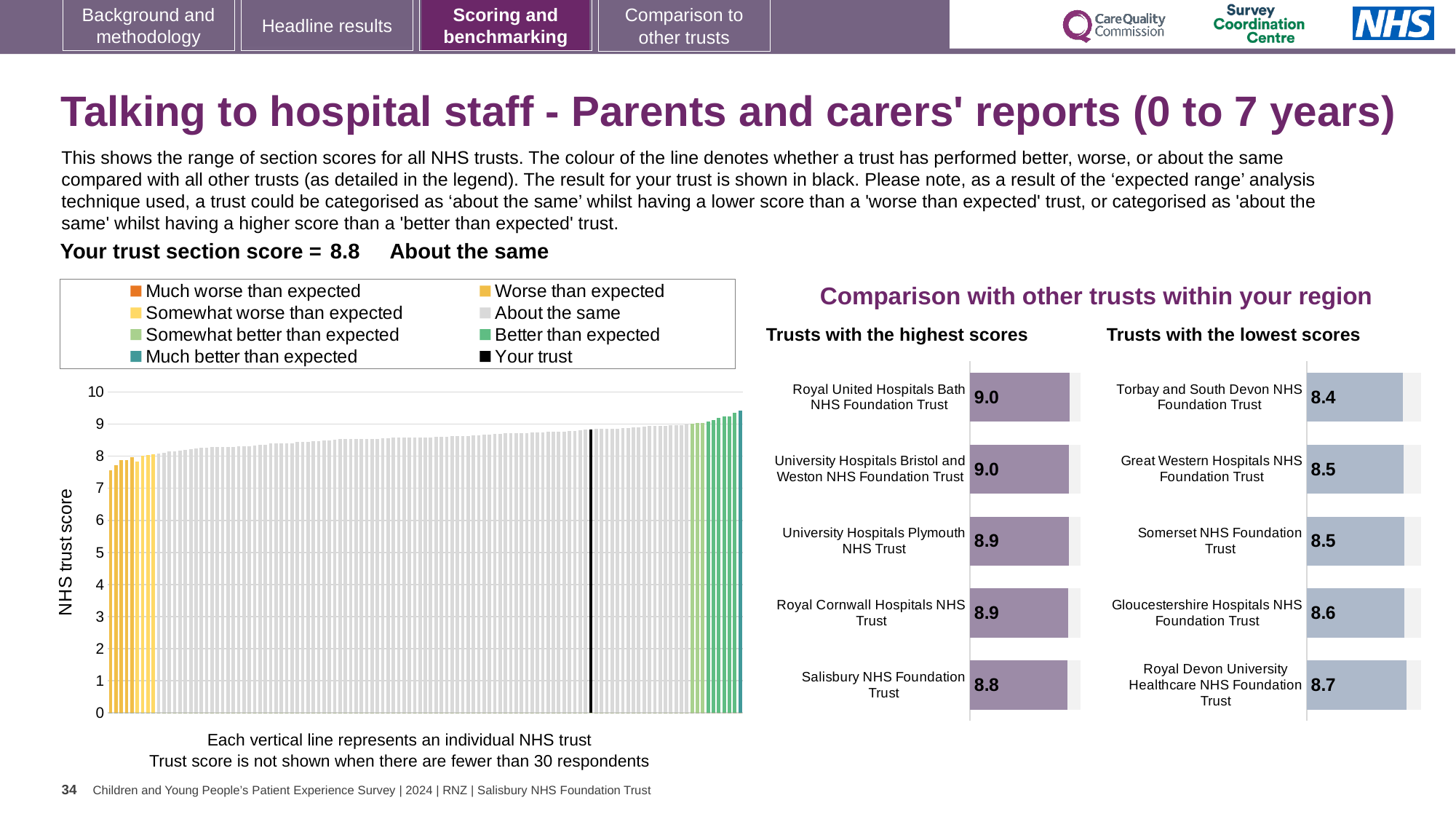
What kind of chart is the large chart on the left showing all NHS trusts? Bar chart In the 'Trusts with the lowest scores' chart, what is the difference between the scores of Royal Devon University Healthcare NHS Foundation Trust and Torbay and South Devon NHS Foundation Trust? 0.3 In the 'Trusts with the highest scores' chart, what is the score for Royal Cornwall Hospitals NHS Trust? 8.9 In the 'Trusts with the lowest scores' chart, what is the score for Gloucestershire Hospitals NHS Foundation Trust? 8.6 In the 'Trusts with the highest scores' chart, what is the difference between the scores of Royal United Hospitals Bath NHS Foundation Trust and Salisbury NHS Foundation Trust? 0.2 How many entries does the legend of the large chart on the left list? 8 What is the section score for your trust shown on the slide? 8.8 In the 'Trusts with the lowest scores' chart, which trust has the lowest score? Torbay and South Devon NHS Foundation Trust In the 'Trusts with the highest scores' chart, which trust has the lowest score? Salisbury NHS Foundation Trust How many trusts are shown in the 'Trusts with the highest scores' chart? 5 In the 'Trusts with the lowest scores' chart, which has the higher score: Somerset NHS Foundation Trust or Royal Devon University Healthcare NHS Foundation Trust? Royal Devon University Healthcare NHS Foundation Trust In the large chart on the left, do the trust scores rise or fall from left to right? Rise